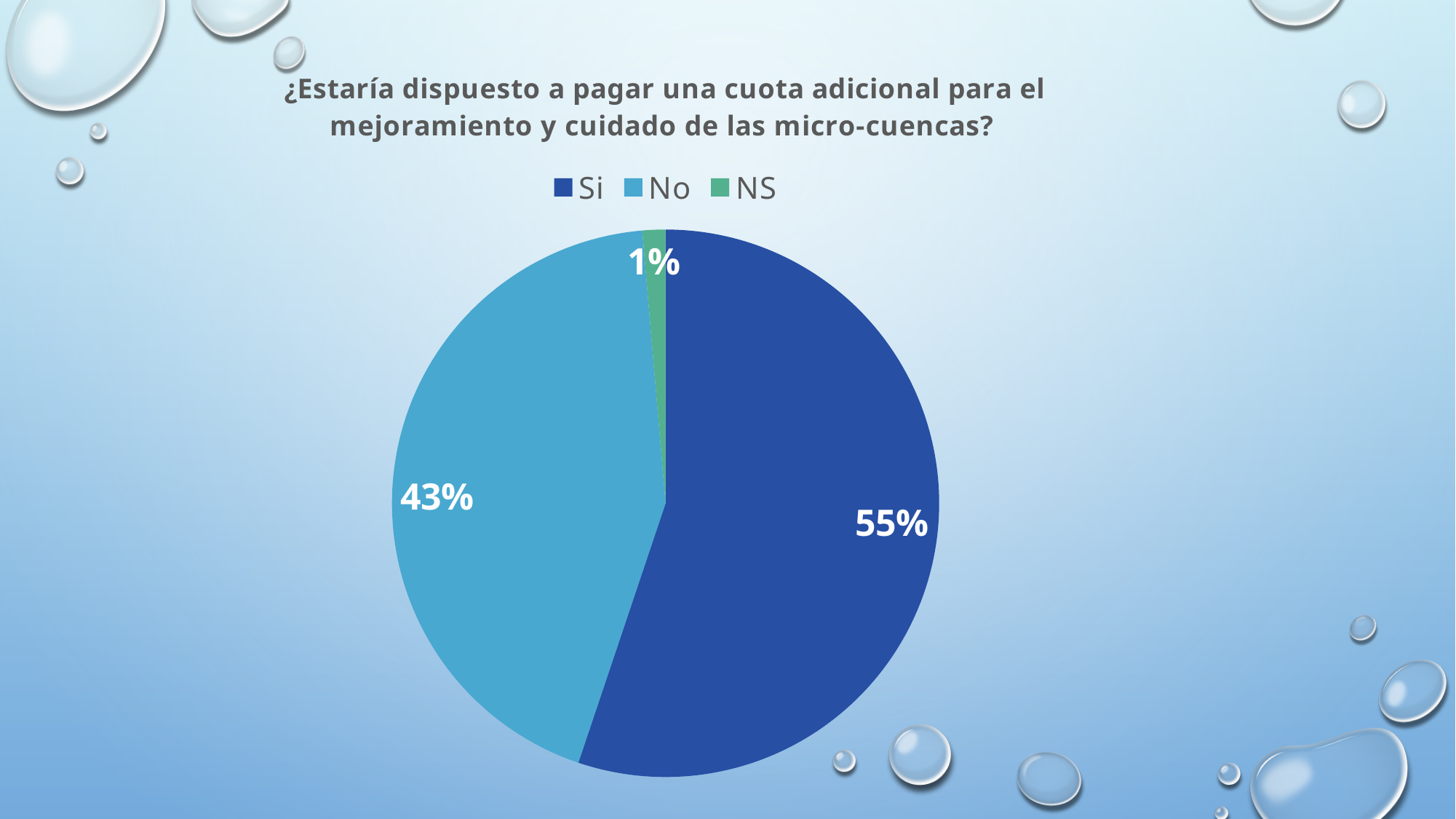
What is the difference in percentage points between the "Si" and "No" slices? 12 Which response has the largest share of the pie? Si What percentage of respondents answered "Si"? 55% What percentage of respondents answered "NS"? 1% What kind of chart is shown on the slide? pie chart What is the title of the chart? ¿Estaría dispuesto a pagar una cuota adicional para el mejoramiento y cuidado de las micro-cuencas? Which slice is larger, "No" or "NS"? No How many entries does the legend list? 3 Which response has the smallest share of the pie? NS What percentage of respondents answered "No"? 43% What colour is the "NS" slice in the pie chart? green How many slices does the pie chart have? 3